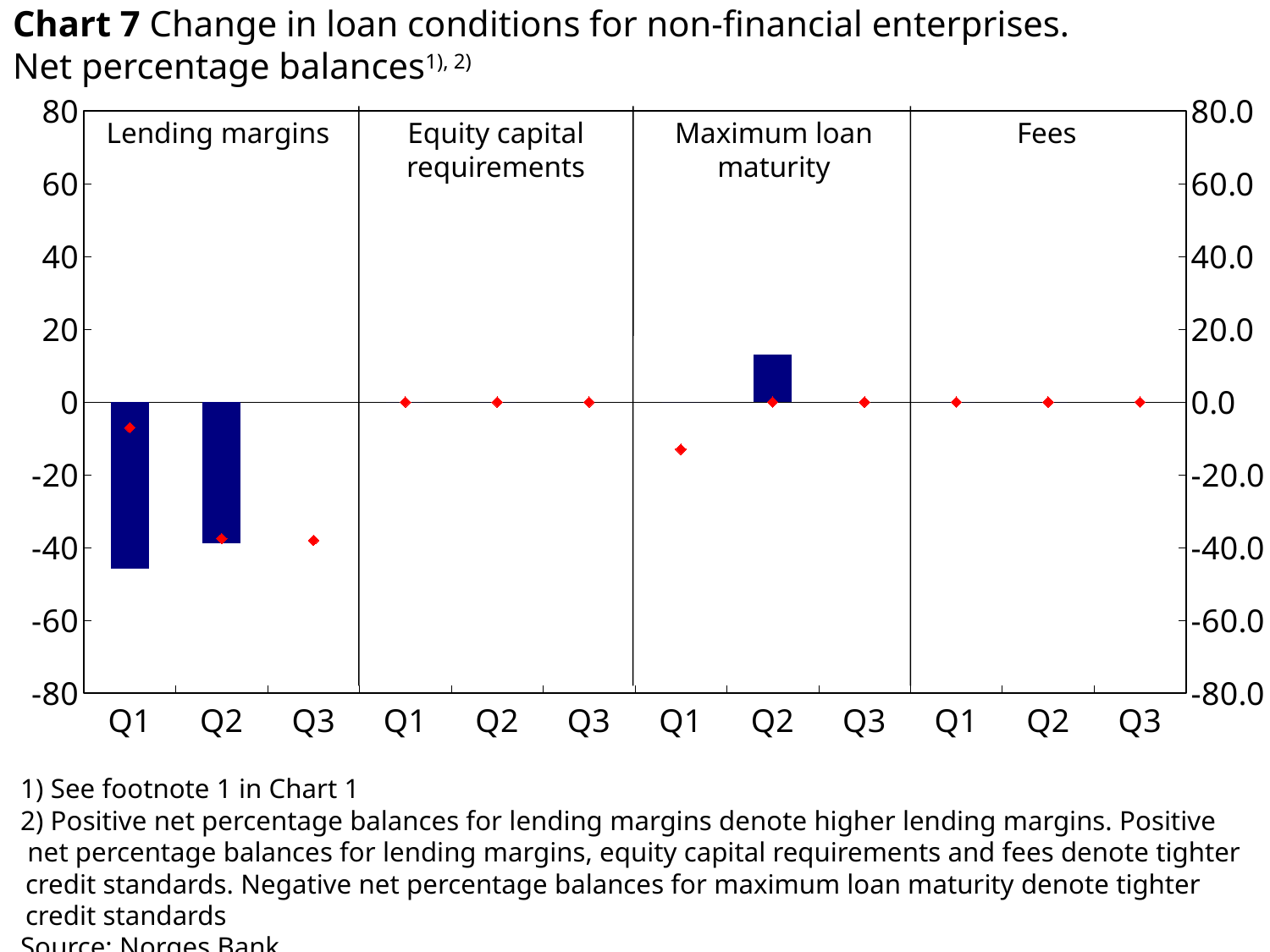
How many quarters are plotted in each panel of Chart 7? 3 What is the range of the left vertical axis in Chart 7? -80 to 80 In the Lending margins panel, is the Q2 bar greater or less than -20? less Which panel contains the only bar above zero in Chart 7? Maximum loan maturity In the Lending margins panel, is the Q1 bar greater or less than -40? less In the Maximum loan maturity panel, is the Q2 bar greater or less than 20? less In the Lending margins panel, which quarter has the lower bar, Q1 or Q2? Q1 What kind of chart is Chart 7? combination bar and marker chart How many loan-condition panels does Chart 7 show? 4 What is the source given for Chart 7? Norges Bank Which panel contains the lowest bar in Chart 7? Lending margins